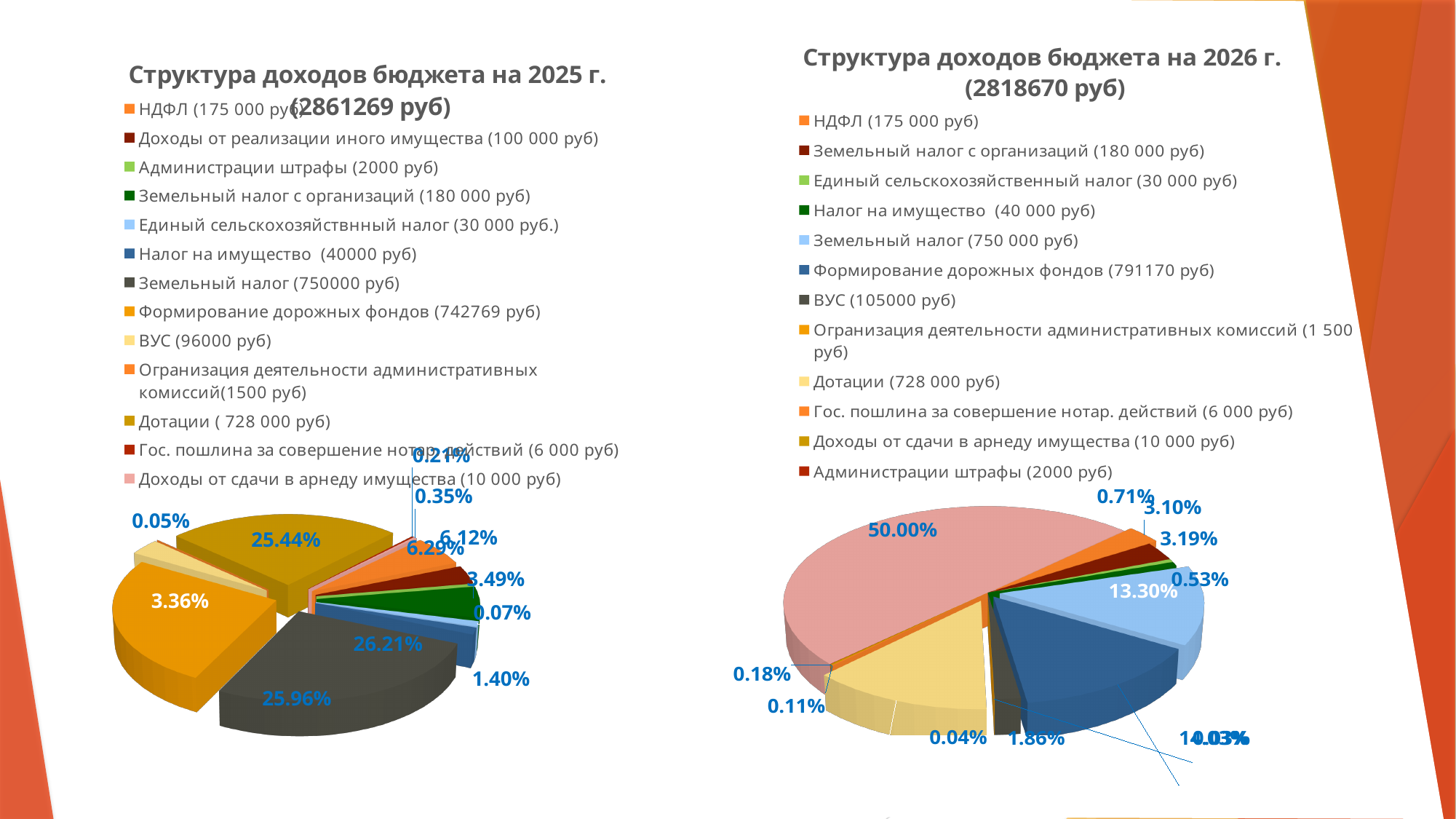
What total budget income is given in the title of the right chart (2026 г.)? 2818670 руб In the right chart (2026 г.), what value does the legend give for Формирование дорожных фондов? 791170 руб What total budget income is given in the title of the left chart (2025 г.)? 2861269 руб In the left chart (2025 г.), what value does the legend give for Формирование дорожных фондов? 742769 руб In the left chart (2025 г.), what value does the legend give for Земельный налог? 750000 руб What is the smallest percentage label shown on the left chart (2025 г.)? 0.05% In the left chart (2025 г.), which is larger according to the legend values: Земельный налог or Формирование дорожных фондов? Земельный налог How many categories does the legend of the right chart (2026 г.) list? 12 How many categories does the legend of the left chart (2025 г.) list? 13 What kind of chart is used on the left side of the slide (Структура доходов бюджета на 2025 г.)? Pie chart What is the largest percentage label shown on the right chart (2026 г.)? 50.00% In the right chart (2026 г.), what value does the legend give for ВУС? 105000 руб